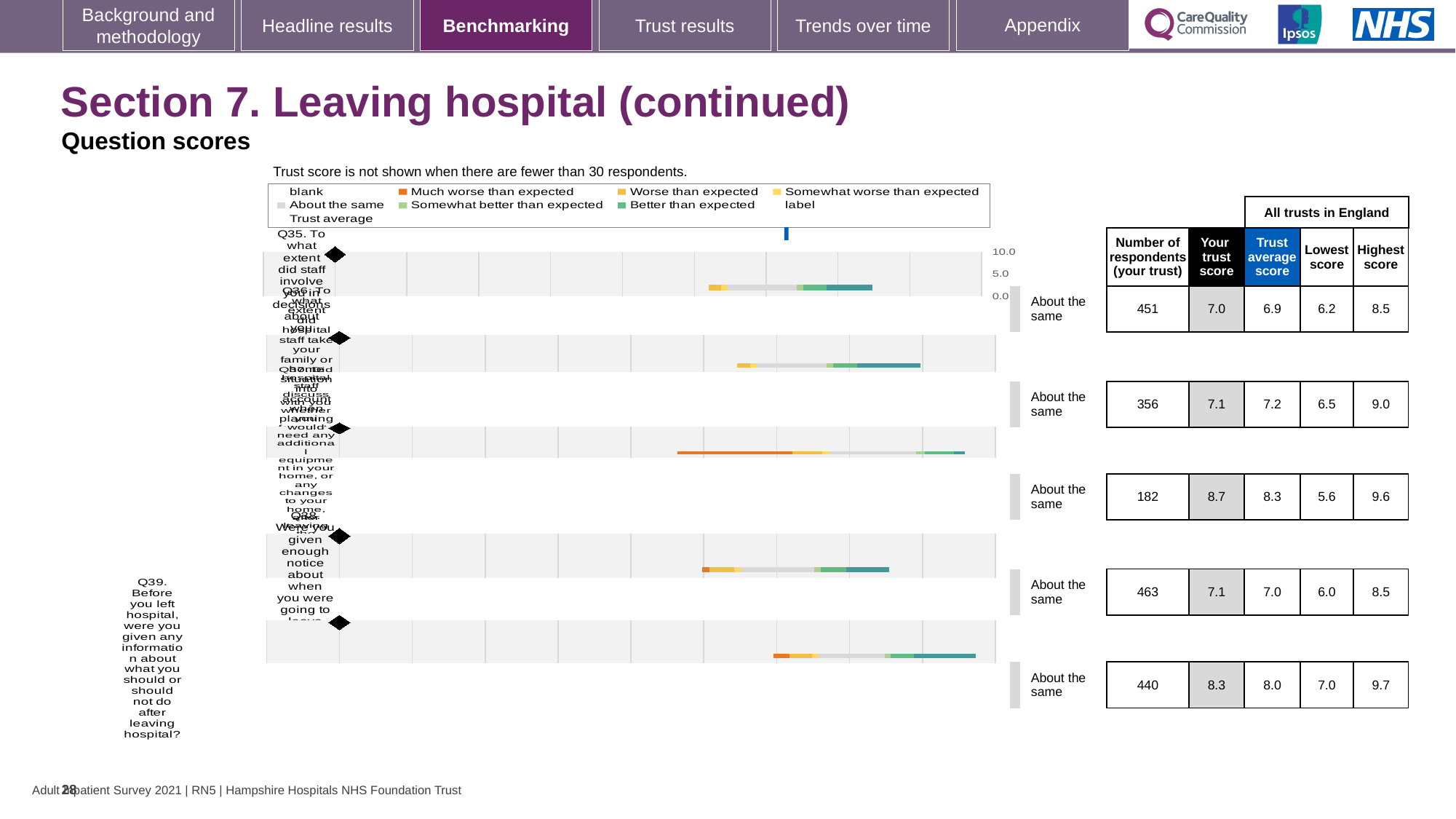
What kind of chart is used to show the question scores? Bar chart Which question row has the fewest respondents? The third row (182) Is the trust score for Q35 higher or lower than the trust average score for Q35? Higher What is the trust average score for Q35 in the table? 6.9 What is the trust score for Q39 about being given information on what you should or should not do after leaving hospital? 8.3 What is the lowest score across all trusts in England for the third question row (182 respondents)? 5.6 What is the number of respondents (your trust) for Q35 about staff involving you in decisions about leaving hospital? 451 Which question row has the highest 'Your trust score' in the table? The third row (8.7) What is the difference between the trust score and the trust average score for Q39? 0.3 What benchmark category is shown for every question on this slide? About the same What is the highest score across all trusts in England for Q39? 9.7 How many question rows are shown in the benchmarking chart? 5